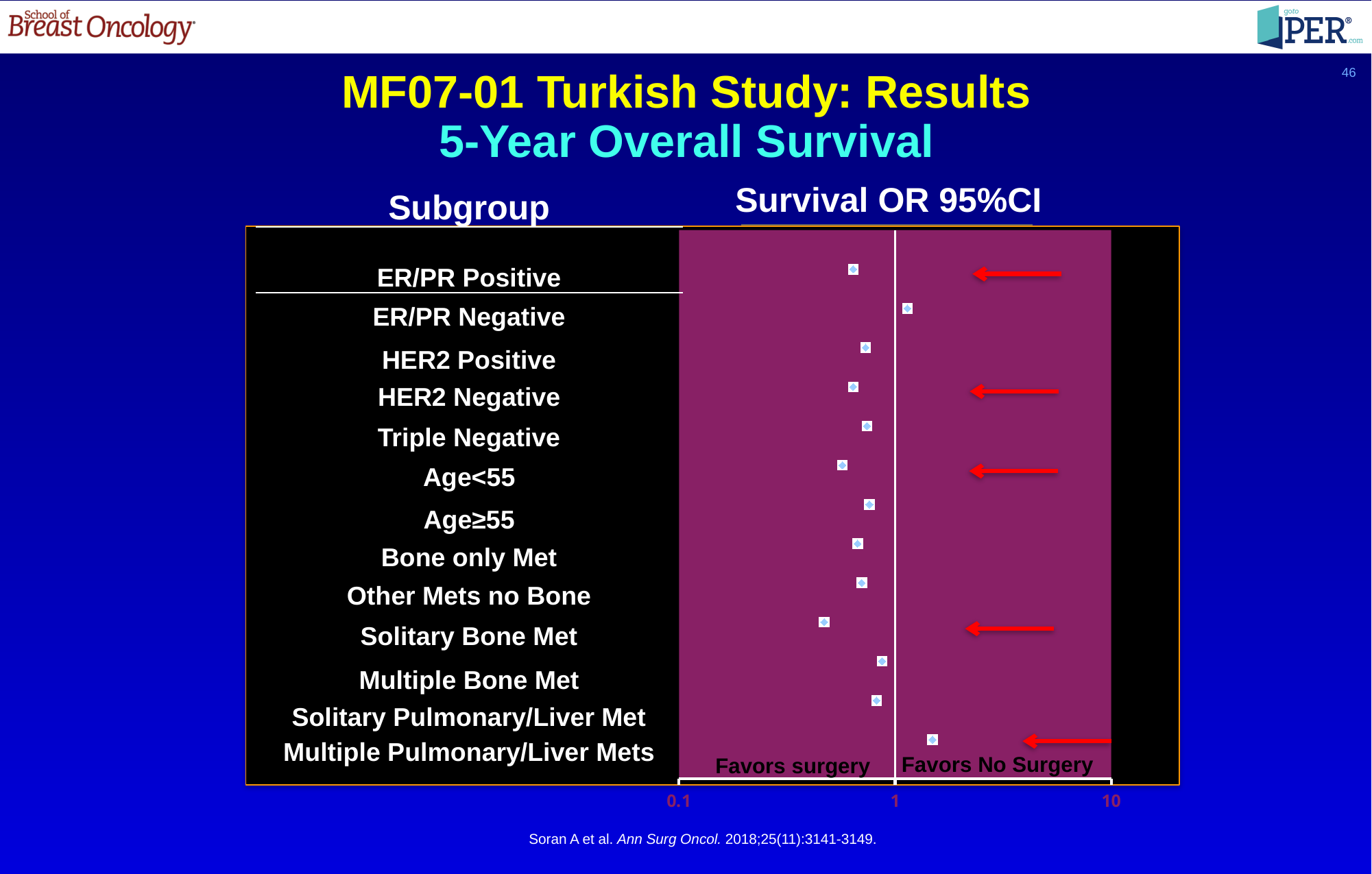
Which subgroup has the lowest survival odds ratio in the chart? Solitary Bone Met Which subgroup has the highest survival odds ratio in the chart? Multiple Pulmonary/Liver Mets Is the survival odds ratio for Age<55 greater or less than 1? less Which has the larger survival odds ratio, Solitary Bone Met or Multiple Bone Met? Multiple Bone Met Which has the larger survival odds ratio, ER/PR Positive or ER/PR Negative? ER/PR Negative Is the survival odds ratio for ER/PR Negative greater or less than 1? greater Is the survival odds ratio for Multiple Pulmonary/Liver Mets greater or less than 1? greater What kind of chart is shown on the slide? Forest plot (dot plot of odds ratios) What does the left side of the chart's x axis (below 1) favor, according to the label? Favors surgery How many subgroups are plotted in the chart? 13